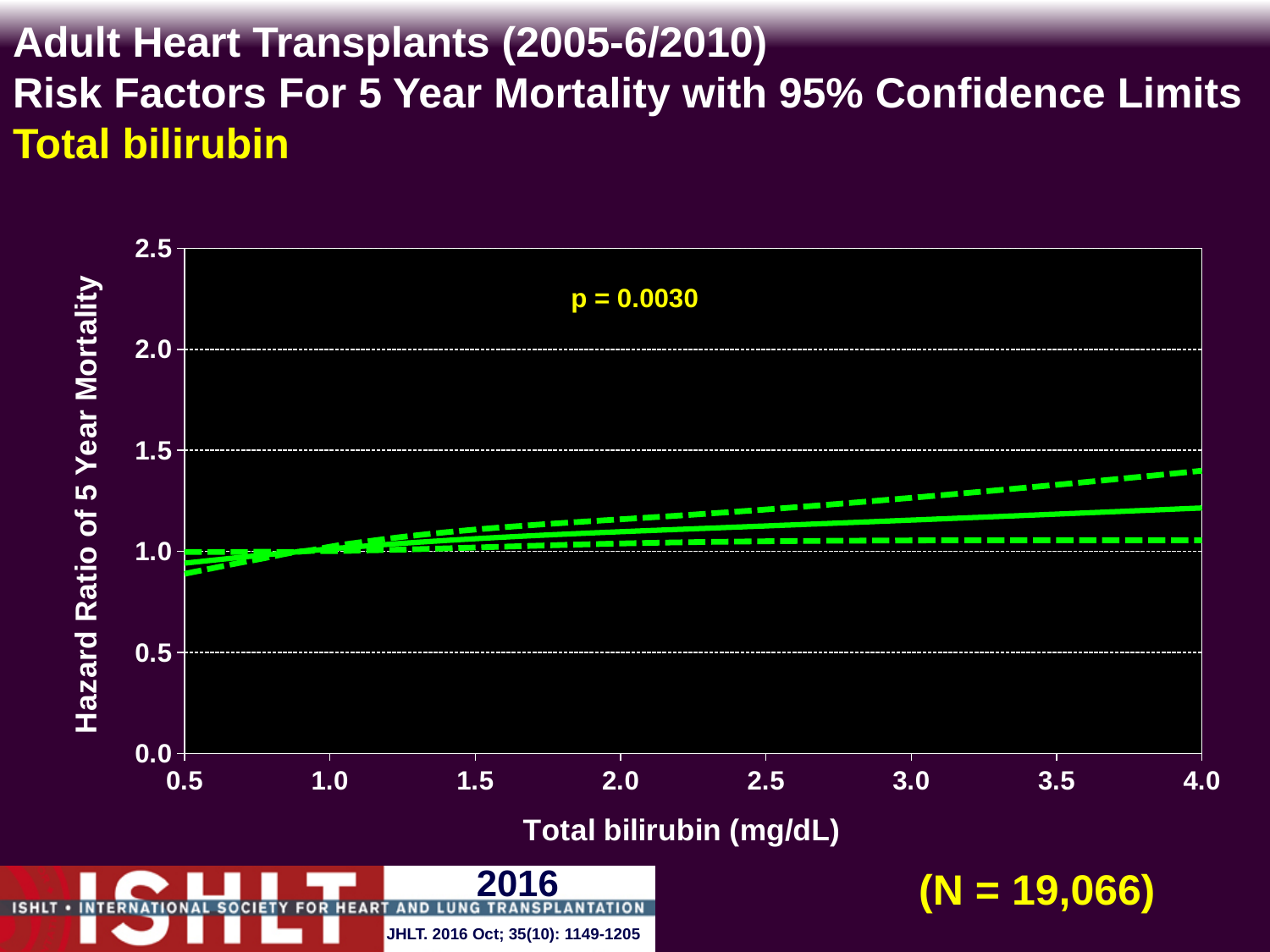
What sample size (N) is printed on the slide? N = 19,066 Is the upper 95% confidence limit (upper dashed line) at a total bilirubin of 4.0 mg/dL greater or less than 1.5? less What kind of chart is shown on the slide? line chart Is the hazard ratio (solid line) at a total bilirubin of 4.0 mg/dL greater or less than 1.5? less How many lines are plotted on the chart? 3 Does the solid hazard ratio line rise or fall as total bilirubin increases from 0.5 to 4.0 mg/dL? rise What p-value is printed on the chart? p = 0.0030 Is the hazard ratio (solid line) at a total bilirubin of 2.0 mg/dL greater or less than 0.5? greater How many tick labels are shown on the x axis? 8 What is the highest value labelled on the y axis? 2.5